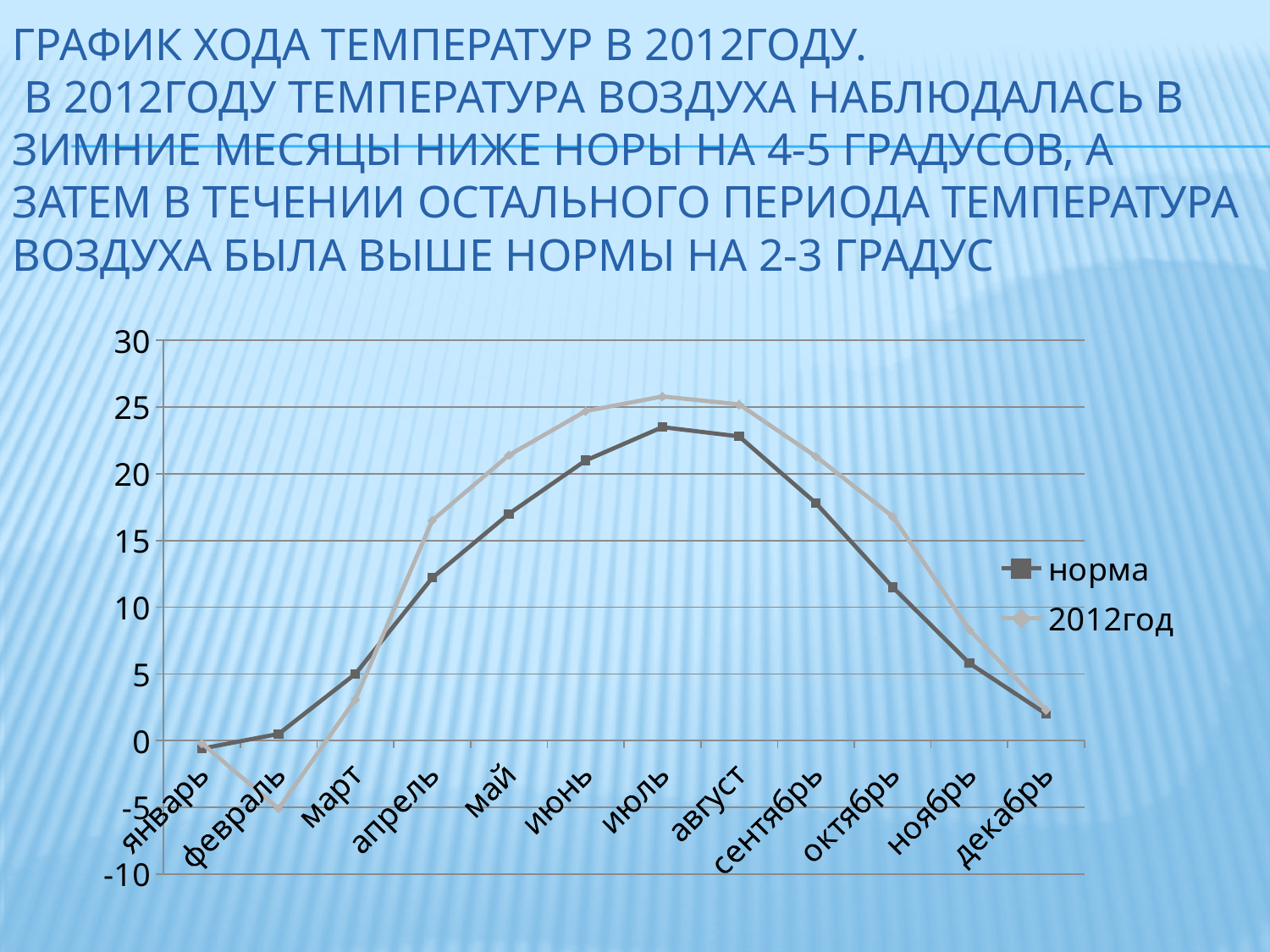
Which series are listed in the legend? норма and 2012год Is the value of норма in ноябрь greater or less than 10? less In апрель, which series has the higher value, норма or 2012год? 2012год What kind of chart is shown on the slide? line chart In март, which series has the higher value, норма or 2012год? норма In which month does the 2012год series reach its lowest value? февраль How many months are plotted along the x axis? 12 Is the value of 2012год in октябрь greater or less than 15? greater Is the value of норма in май greater or less than 15? greater How many series does the legend list? 2 In which month does the 2012год series reach its highest value? июль Does the норма series rise or fall from июль to декабрь? fall